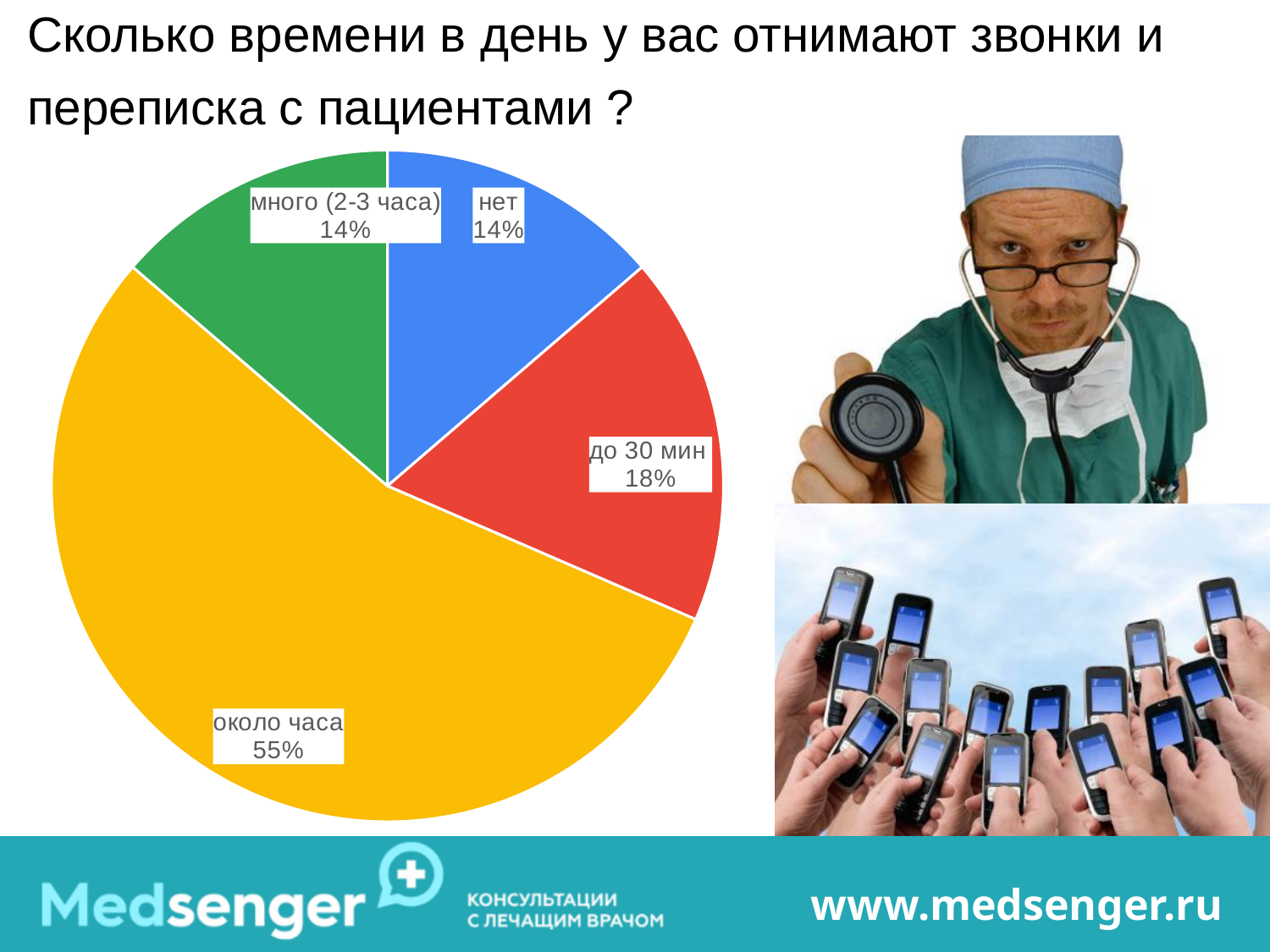
What kind of chart is shown on the slide? pie chart What is the combined share of the "нет" and "много (2-3 часа)" slices? 28% Which category has the largest slice of the pie? около часа Which slice is larger: "до 30 мин" or "нет"? до 30 мин What share of the pie does the "нет" slice represent? 14% What is the difference in percentage points between the "около часа" slice and the "до 30 мин" slice? 37 What share of the pie does the "до 30 мин" slice represent? 18% What share of the pie does the "много (2-3 часа)" slice represent? 14% How many slices does the pie chart have? 4 What colour is the "около часа" slice? yellow What colour is the "до 30 мин" slice? red